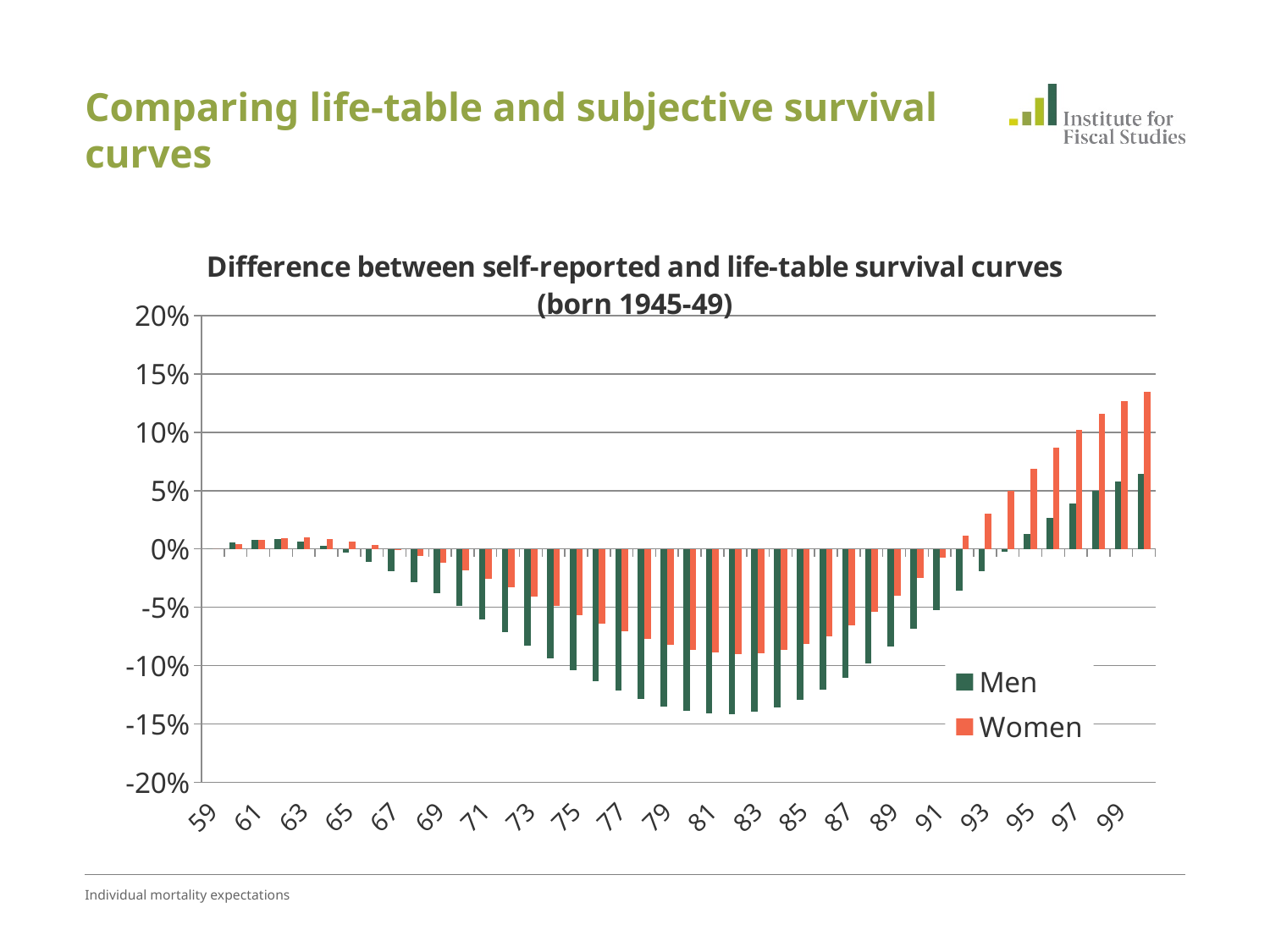
Is the value for Men at age 99 greater or less than 5%? greater How many series does the legend list? 2 Is the value for Men at age 77 greater or less than -10%? less What kind of chart is shown on the slide? bar chart Do the Men values rise or fall along the x axis from age 83 to age 99? rise Is the value for Women at age 99 greater or less than 10%? greater What are the two series named in the legend? Men and Women What is the title of the chart? Difference between self-reported and life-table survival curves (born 1945-49) At age 81, which series has the larger value, Men or Women? Women Which series reaches the highest value on the chart? Women